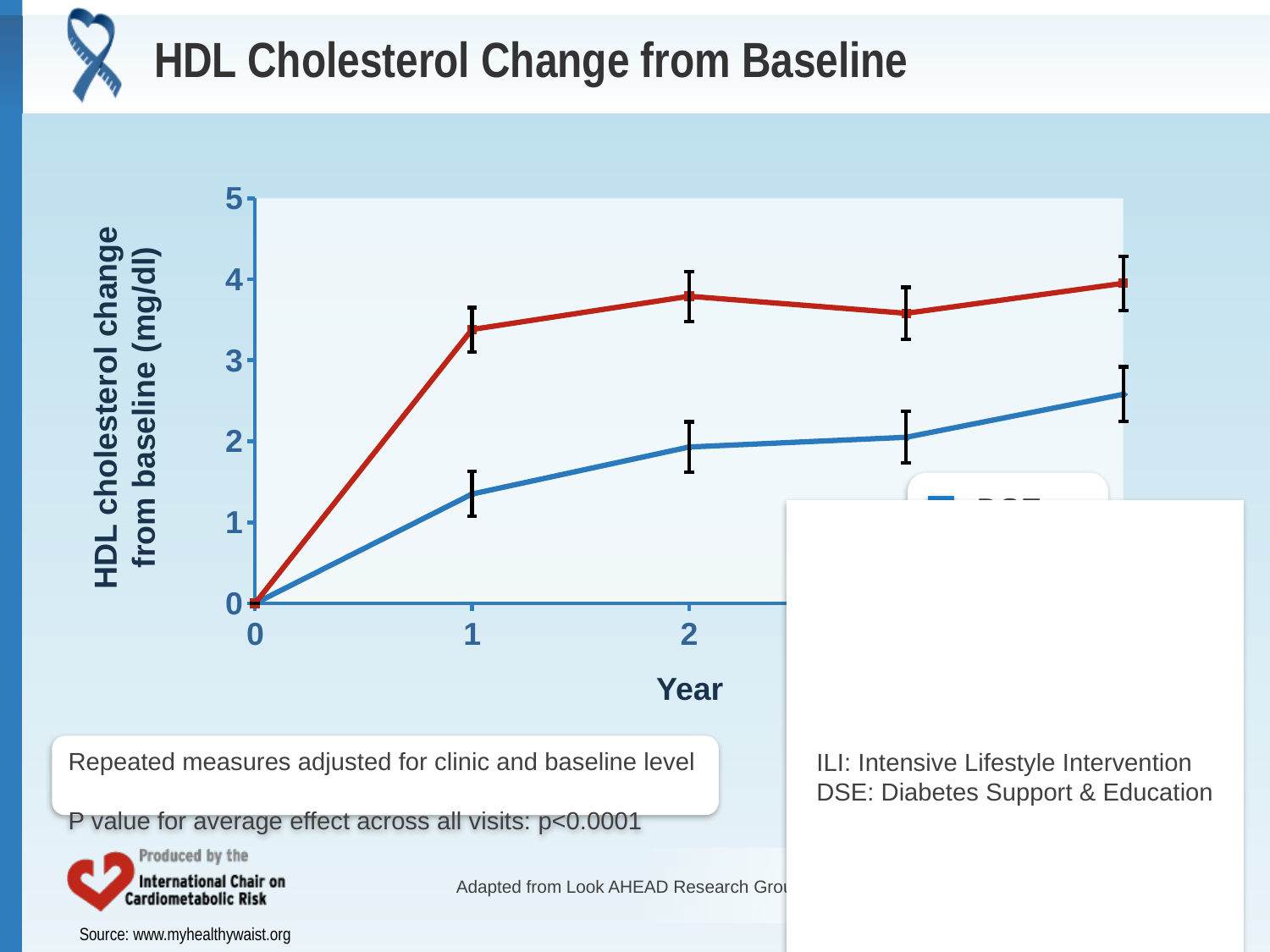
At year 1, which line is higher, the red line or the blue line? the red line Does the red line rise or fall from year 0 to year 1? rise Is the value of the red line at year 2 greater or less than 3? greater What kind of chart is shown on the slide? line chart What is the value of both lines at year 0? 0 Is the value of the blue line at year 1 greater or less than 2? less At year 2, which line is higher, the red line or the blue line? the red line Does the blue line rise or fall from year 0 to year 2? rise What is the label of the vertical axis? HDL cholesterol change from baseline (mg/dl) Is the value of the red line at year 1 greater or less than 3? greater What is the title of the chart on the slide? HDL Cholesterol Change from Baseline